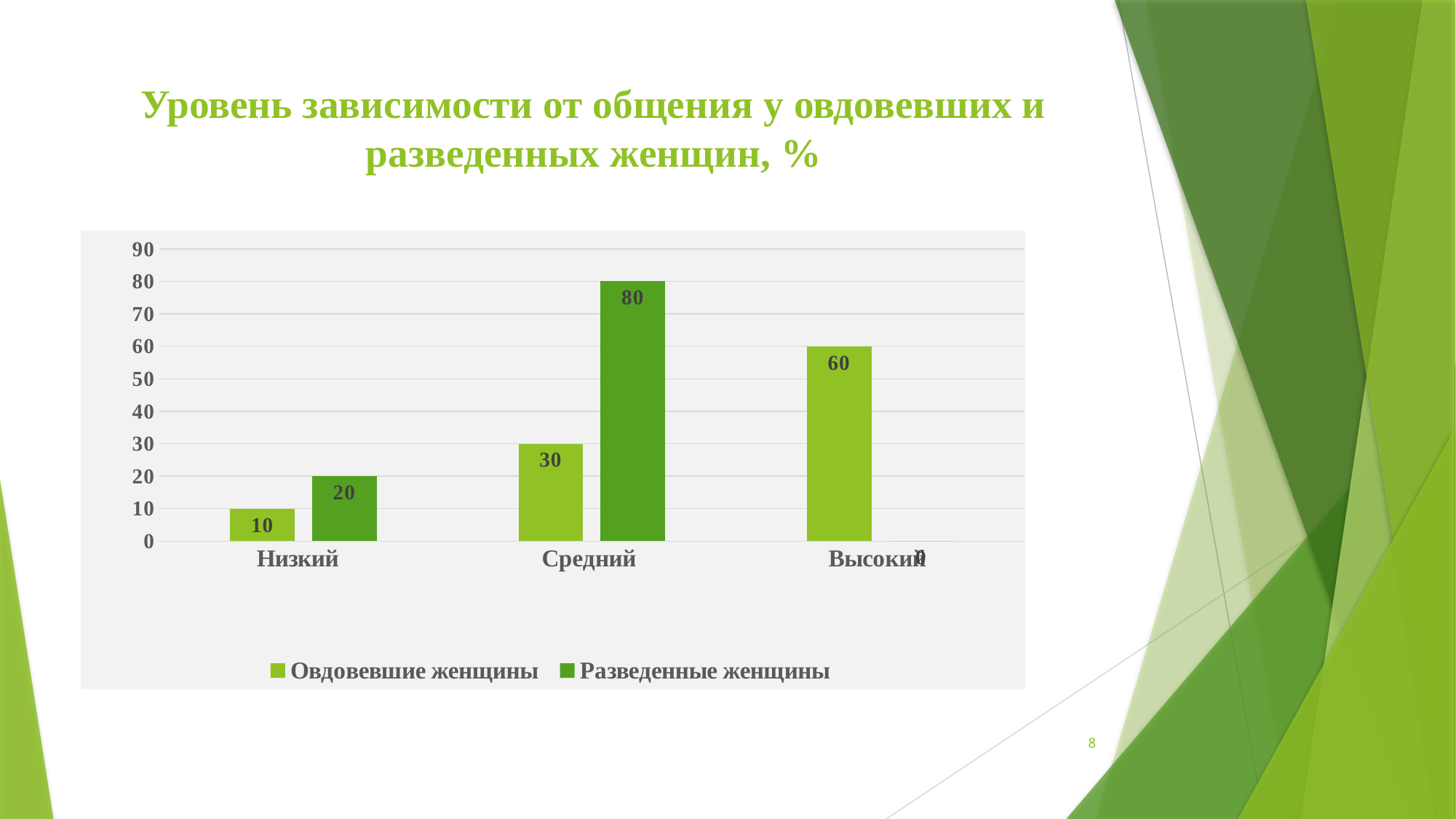
What is the value for Разведенные женщины in the Средний category? 80 Which category has the highest value for Овдовевшие женщины? Высокий Which category has the highest value for Разведенные женщины? Средний Which category has the lowest value for Овдовевшие женщины? Низкий What kind of chart is shown on the slide? Bar chart How many categories are shown on the x axis? 3 What is the difference between Разведенные женщины and Овдовевшие женщины in the Средний category? 50 What is the value for Овдовевшие женщины in the Низкий category? 10 How many series does the legend list? 2 What is the value for Овдовевшие женщины in the Высокий category? 60 In the Низкий category, which series has the larger value? Разведенные женщины What is the value for Разведенные женщины in the Низкий category? 20